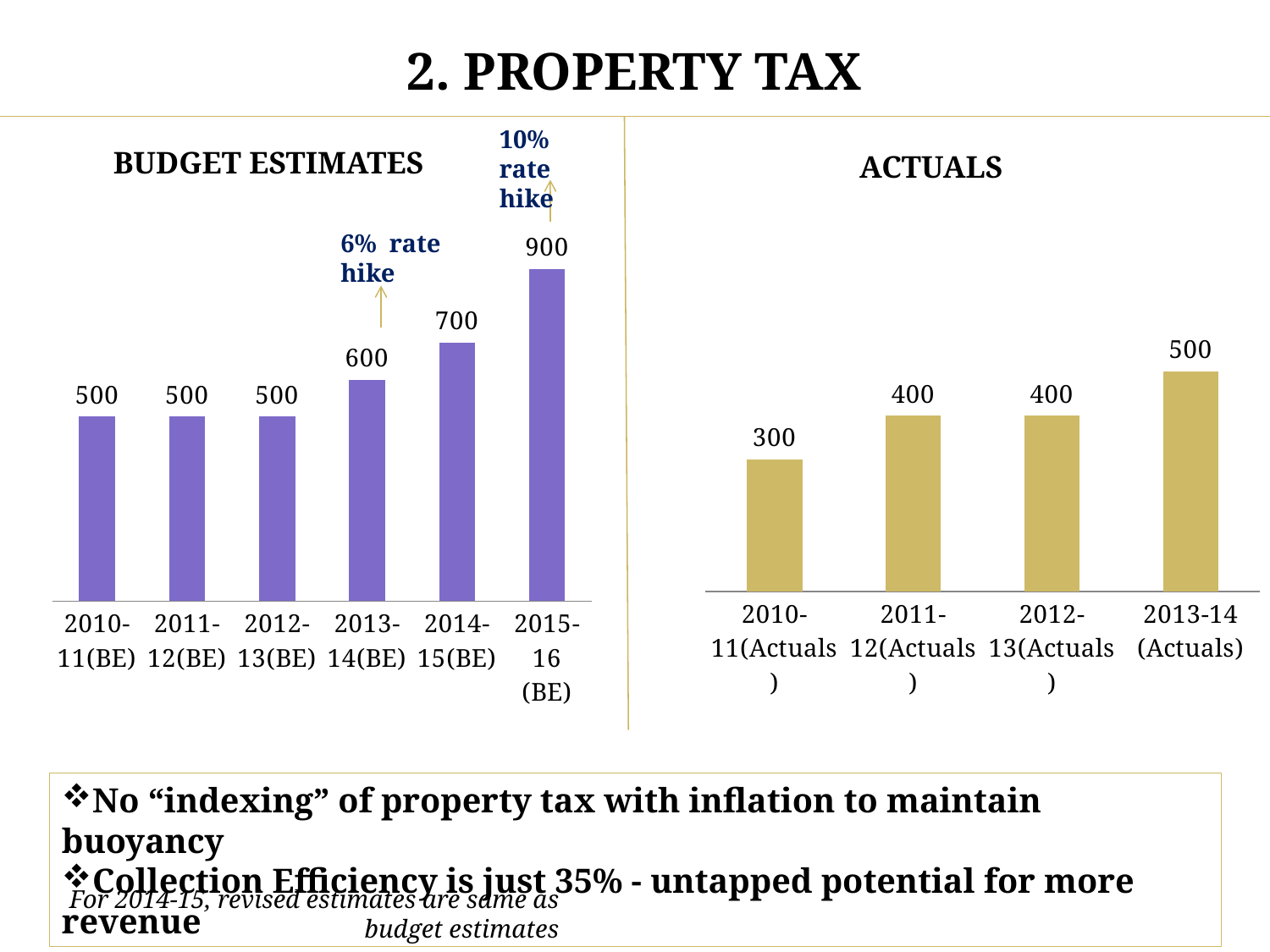
Which is larger: the Budget Estimates value for 2013-14 (BE) or the Actuals value for 2013-14 (Actuals)? 2013-14 (BE) What type of chart is the Actuals chart? Bar chart In the Budget Estimates chart, what is the value for 2013-14 (BE)? 600 In the Actuals chart, what is the value for 2010-11 (Actuals)? 300 In the Actuals chart, what is the difference between the values for 2013-14 (Actuals) and 2010-11 (Actuals)? 200 In the Budget Estimates chart, what is the value for 2015-16 (BE)? 900 How many bars are in the Actuals chart? 4 In the Actuals chart, which year has the lowest value? 2010-11 (Actuals) In the Actuals chart, which year has the highest value? 2013-14 (Actuals) In the Budget Estimates chart, which year has the highest value? 2015-16 (BE) In the Budget Estimates chart, what is the difference between the values for 2015-16 (BE) and 2014-15 (BE)? 200 How many bars are in the Budget Estimates chart? 6